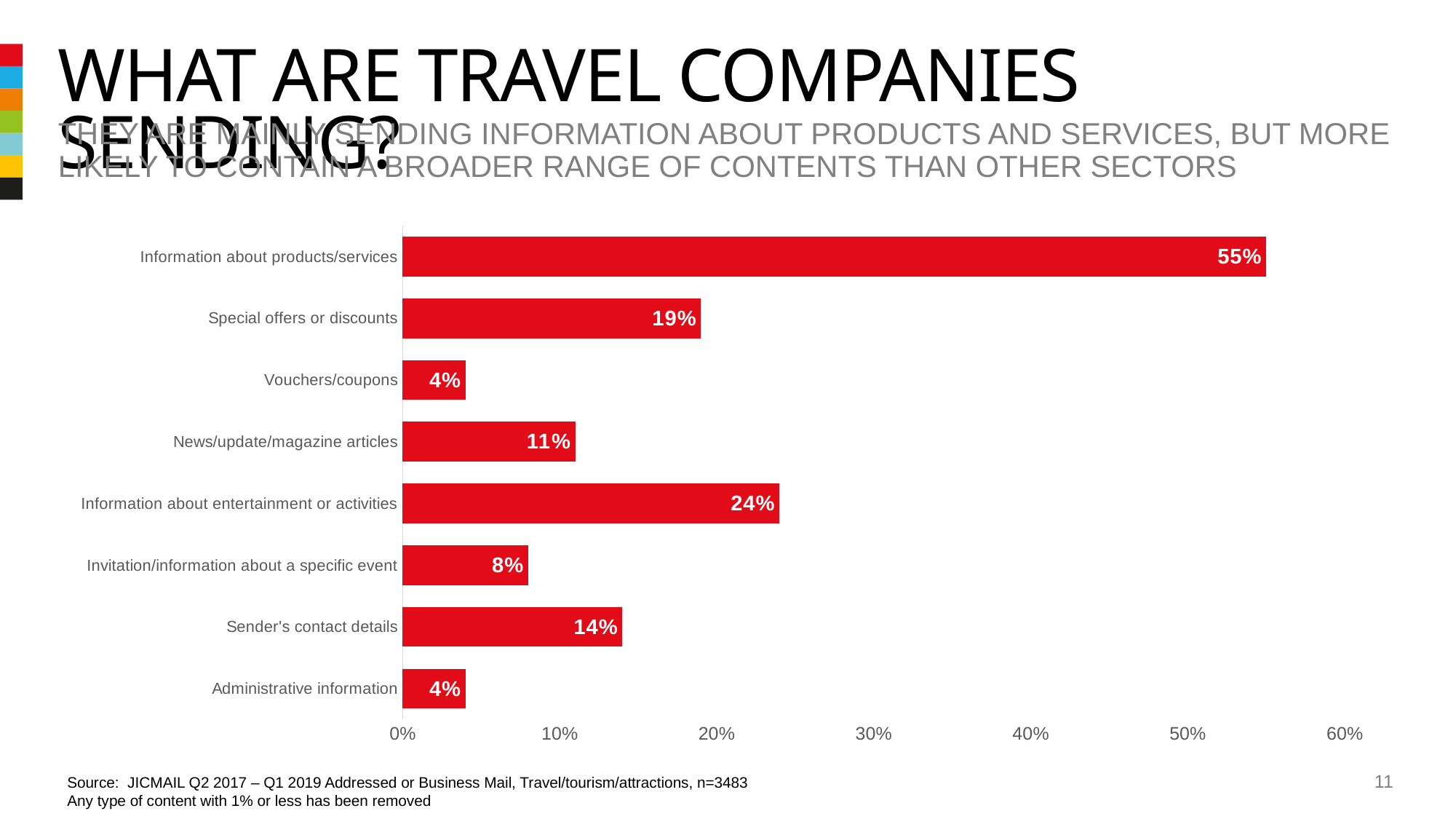
What is the value for Information about entertainment or activities? 24% Which is larger, Sender's contact details or Invitation/information about a specific event? Sender's contact details What kind of chart is shown on the slide? Bar chart What is the highest value shown on the x axis? 60% How many categories are shown in the chart? 8 What is the value for Special offers or discounts? 19% Is the value for Information about products/services greater or less than 50%? greater Which category has the highest value? Information about products/services What is the value for Information about products/services? 55% What is the difference between Information about entertainment or activities and News/update/magazine articles? 13% What is the value for Sender's contact details? 14% What is the difference between Information about products/services and Special offers or discounts? 36%